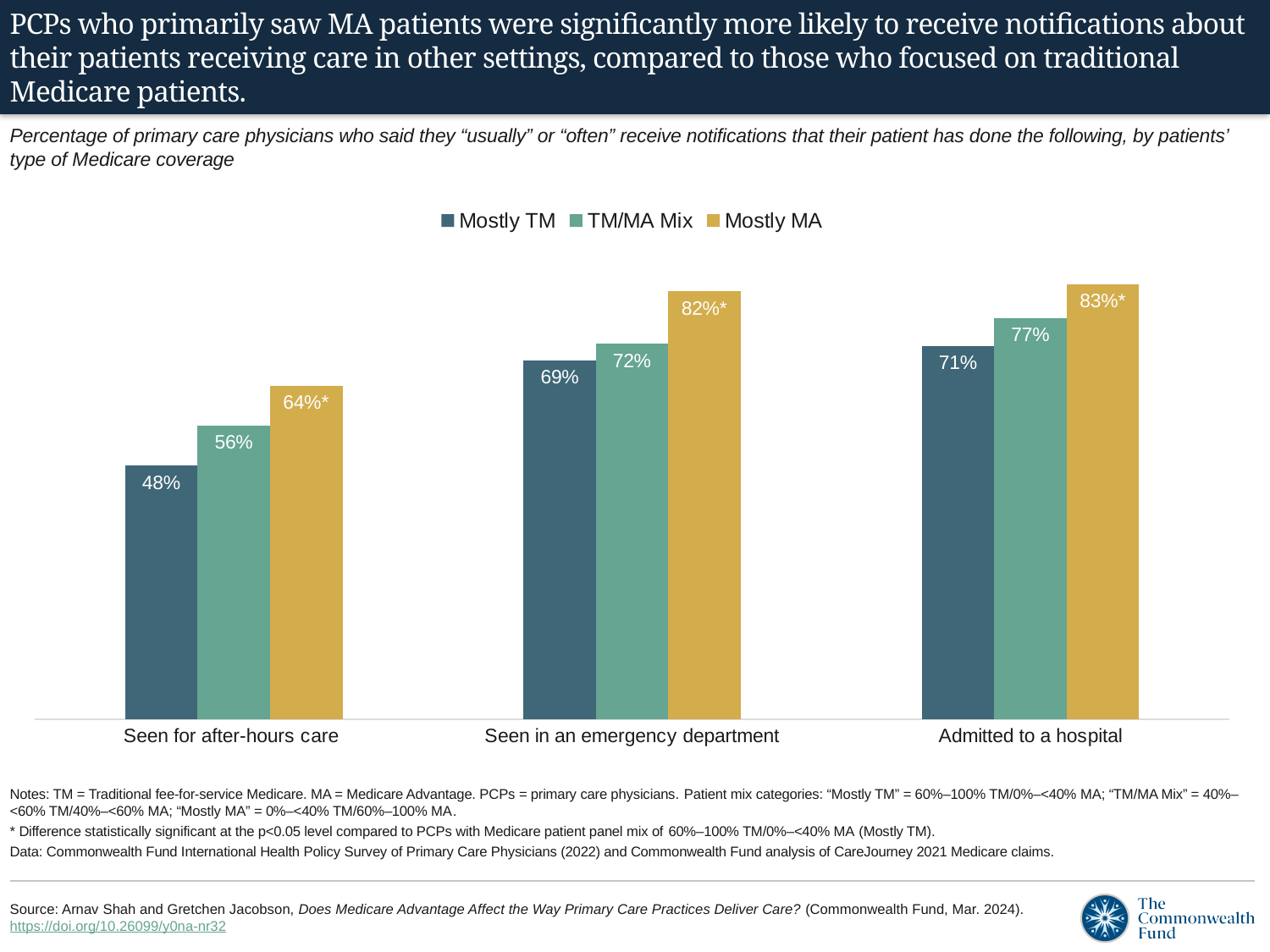
What is the value for Mostly MA physicians for 'Seen in an emergency department'? 82%* How many categories are shown on the x axis? 3 How many series does the legend list? 3 Which is larger for 'Seen in an emergency department': the Mostly TM value or the TM/MA Mix value? TM/MA Mix What percentage of Mostly TM physicians said they usually or often receive notifications that their patient was seen for after-hours care? 48% What is the difference between the Mostly MA and Mostly TM values for 'Seen for after-hours care'? 16 percentage points Which category has the lowest value for Mostly TM physicians? Seen for after-hours care Within each category, do the values rise or fall moving from Mostly TM to Mostly MA? Rise Which category has the highest value for Mostly MA physicians? Admitted to a hospital Which series is shown in yellow/gold in the legend? Mostly MA What kind of chart is shown on the slide? Bar chart What is the value for TM/MA Mix physicians for 'Admitted to a hospital'? 77%